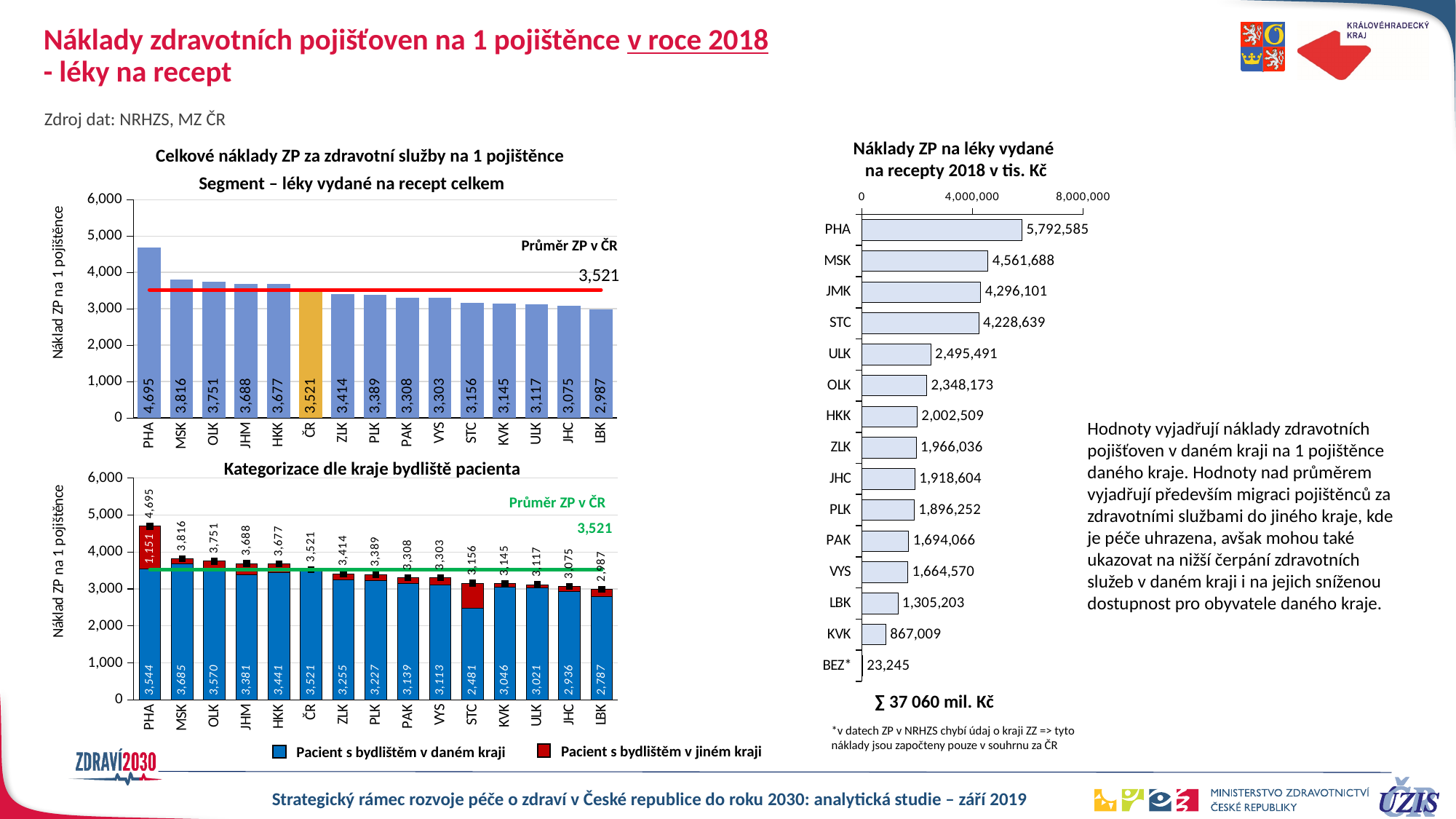
In the right chart 'Náklady ZP na léky vydané na recepty 2018 v tis. Kč', which region has the highest value? PHA What kind of chart is the right chart 'Náklady ZP na léky vydané na recepty 2018 v tis. Kč'? Bar chart In the bottom-left chart 'Kategorizace dle kraje bydliště pacienta', what is the value of 'Pacient s bydlištěm v jiném kraji' for PHA? 1,151 In the top-left chart 'Celkové náklady ZP za zdravotní služby na 1 pojištěnce', what is the value of the 'Průměr ZP v ČR' line? 3,521 In the top-left chart 'Celkové náklady ZP za zdravotní služby na 1 pojištěnce', what is the difference between the values for PHA and MSK? 879 How many series does the legend of the bottom-left chart 'Kategorizace dle kraje bydliště pacienta' list? 2 In the top-left chart 'Celkové náklady ZP za zdravotní služby na 1 pojištěnce', which region has the lowest value? LBK In the bottom-left chart 'Kategorizace dle kraje bydliště pacienta', what is the total of the stacked bar for PHA? 4,695 In the bottom-left chart 'Kategorizace dle kraje bydliště pacienta', what is the value of 'Pacient s bydlištěm v daném kraji' for STC? 2,481 In the right chart 'Náklady ZP na léky vydané na recepty 2018 v tis. Kč', what is the value for JMK? 4,296,101 How many categories are shown on the x axis of the top-left chart 'Celkové náklady ZP za zdravotní služby na 1 pojištěnce'? 15 In the top-left chart 'Celkové náklady ZP za zdravotní služby na 1 pojištěnce', what is the value for PHA? 4,695